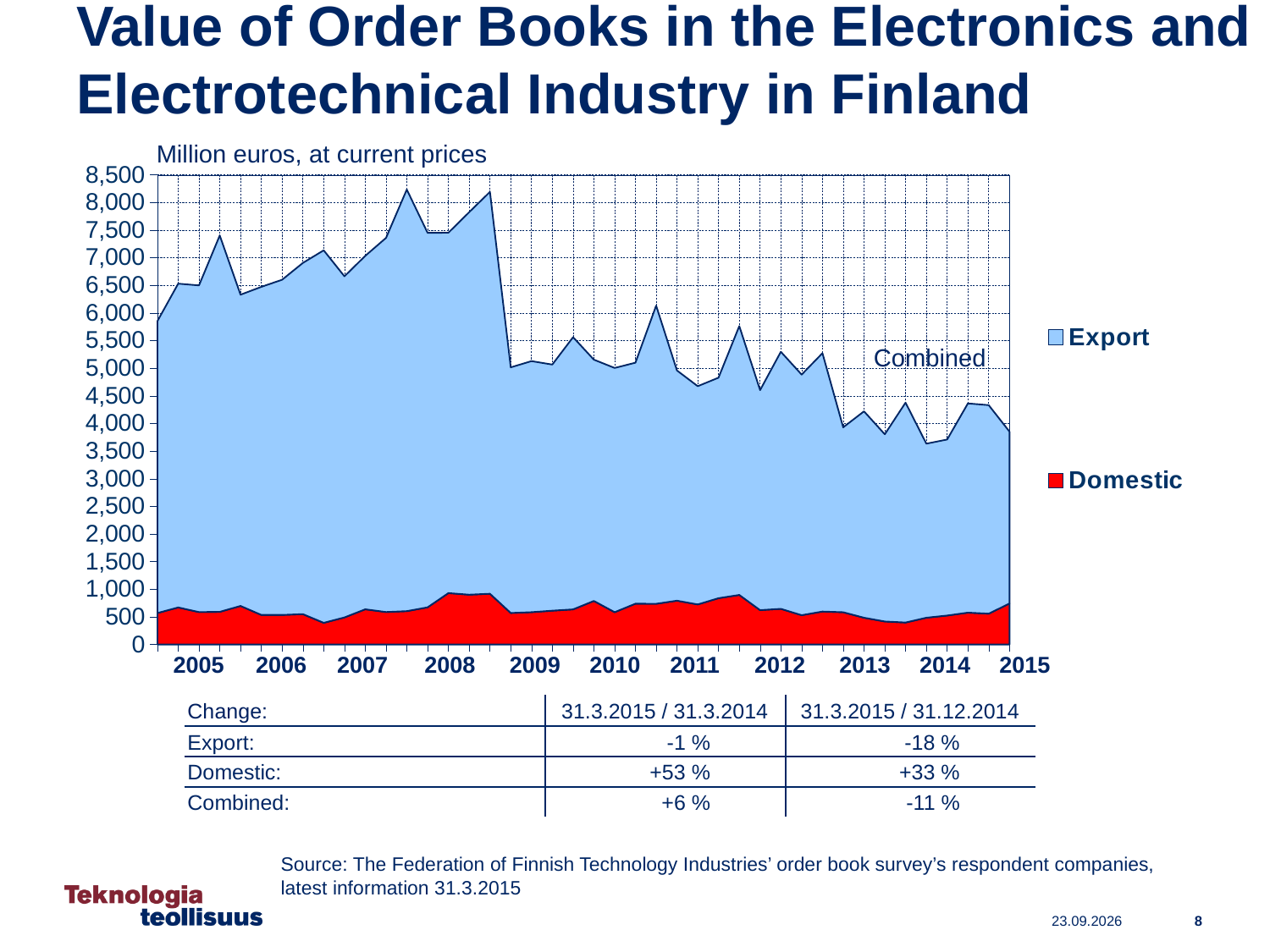
What is the highest value shown on the chart's y axis? 8,500 How many series does the chart legend list? 2 What kind of chart is shown on the slide? Stacked area chart Is the Domestic value in 2008 greater or less than 500? greater Which series accounts for the larger part of the combined order book value throughout the chart, Export or Domestic? Export Is the combined value at the end of the series in 2015 greater or less than 4,500? less Which series is shown in red in the chart? Domestic Does the Domestic series ever exceed 1,000 on the chart? No How many year labels are shown along the x axis of the chart? 11 What unit is stated above the chart's y axis? Million euros, at current prices Does the combined order book value rise or fall overall between 2008 and 2015? Fall